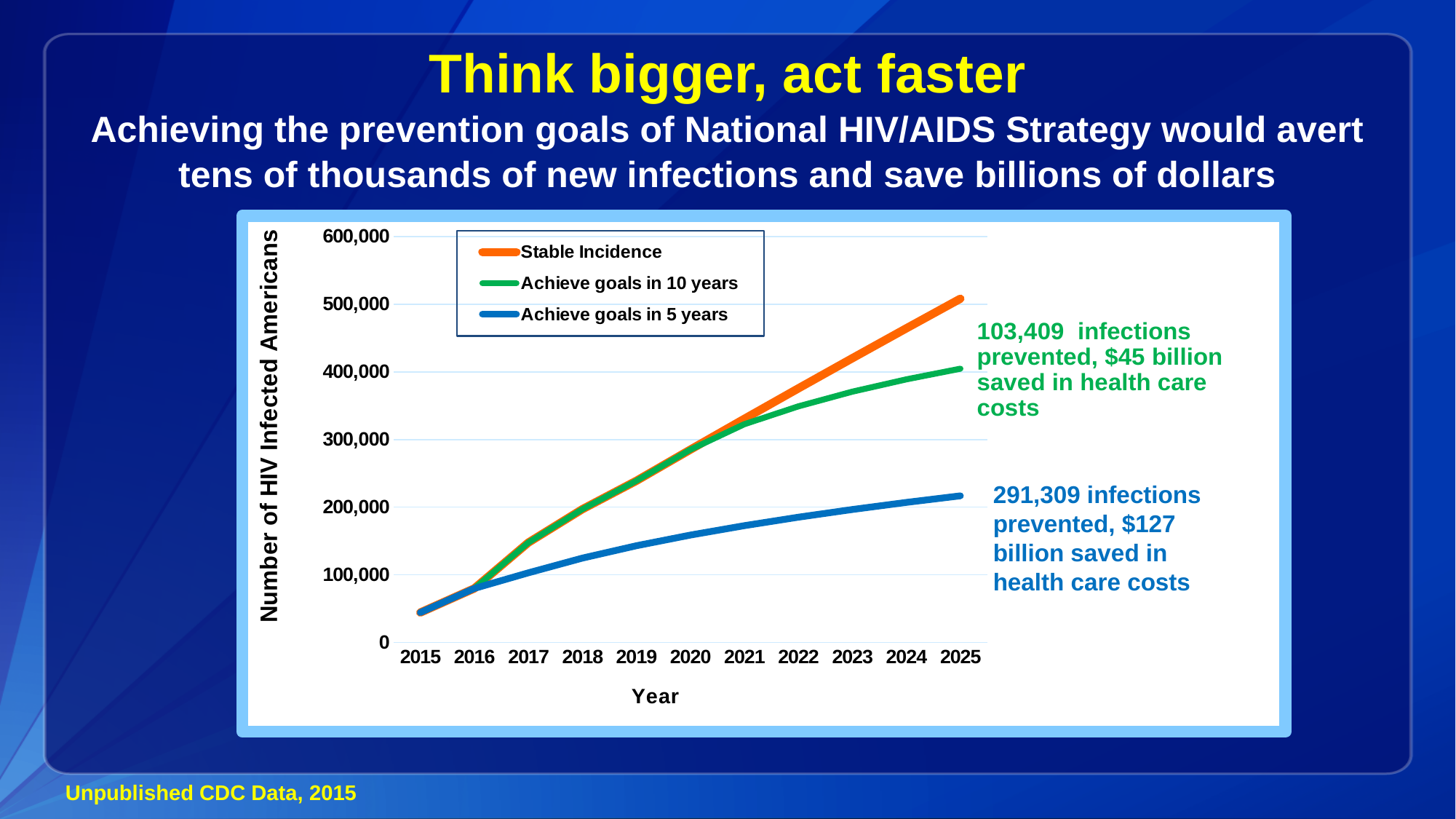
How many years are shown along the x axis? 11 How many series does the legend list? 3 Is the value for Achieve goals in 5 years in 2025 greater or less than 300,000? less According to the annotation, how much is saved in health care costs by achieving goals in 10 years? $45 billion Is the value for Stable Incidence in 2025 greater or less than 400,000? greater According to the annotation, how many infections are prevented by achieving goals in 5 years? 291,309 Which is larger in 2025: Achieve goals in 10 years or Achieve goals in 5 years? Achieve goals in 10 years Is the value for Achieve goals in 10 years in 2020 greater or less than 200,000? greater Which series has the highest value in 2025? Stable Incidence Do the values for Stable Incidence rise or fall from 2015 to 2025? rise Which series has the lowest value in 2025? Achieve goals in 5 years What kind of chart is shown on the slide? line chart